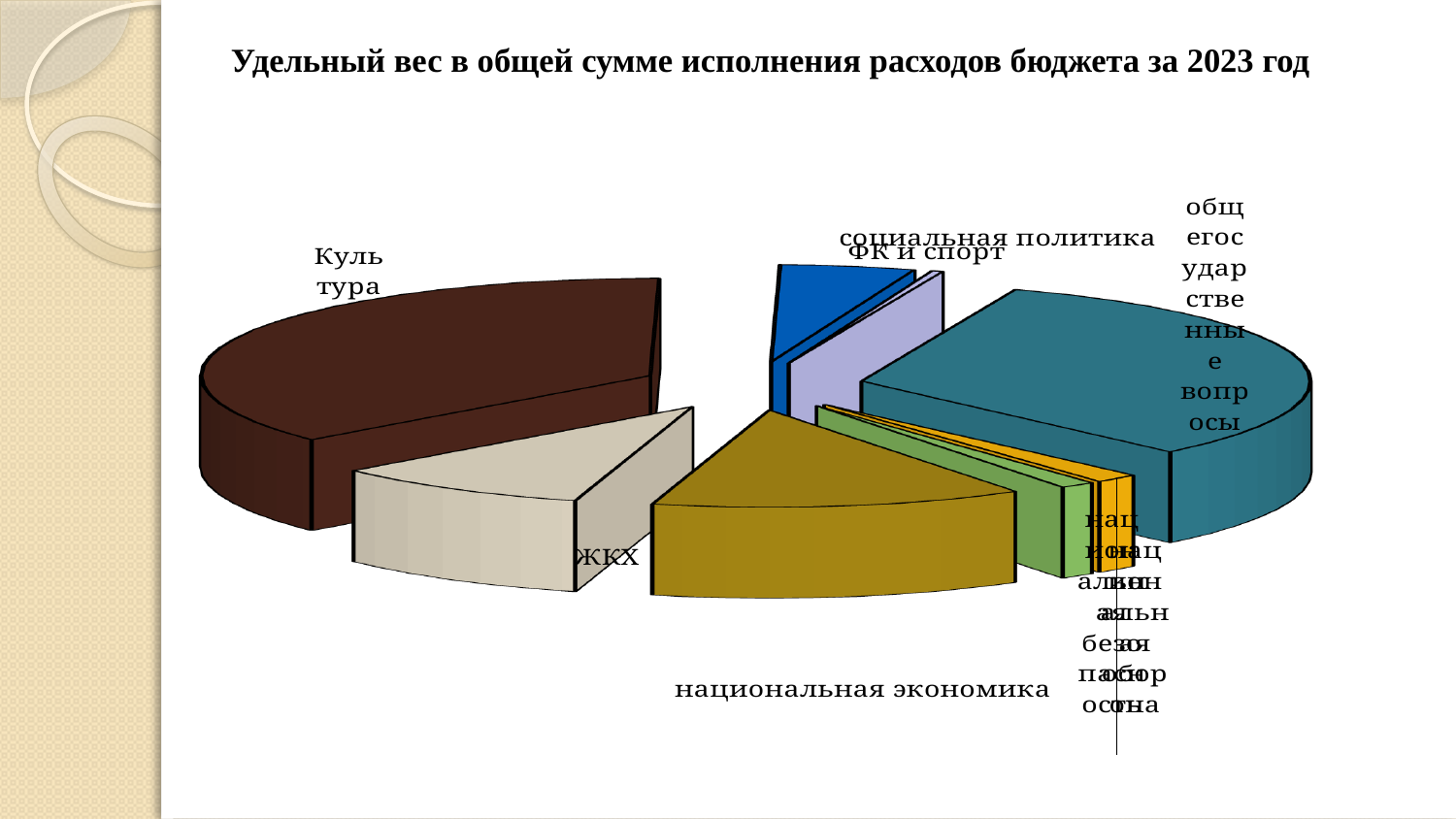
What kind of chart is shown on the slide? pie chart Which slice is larger, национальная экономика or социальная политика? национальная экономика Which slice is larger, общегосударственные вопросы or ФК и спорт? общегосударственные вопросы What colour is the Культура slice? dark brown Which slice is larger, Культура or ЖКХ? Культура Which category has the largest slice of the pie? Культура What is the title of the chart? Удельный вес в общей сумме исполнения расходов бюджета за 2023 год